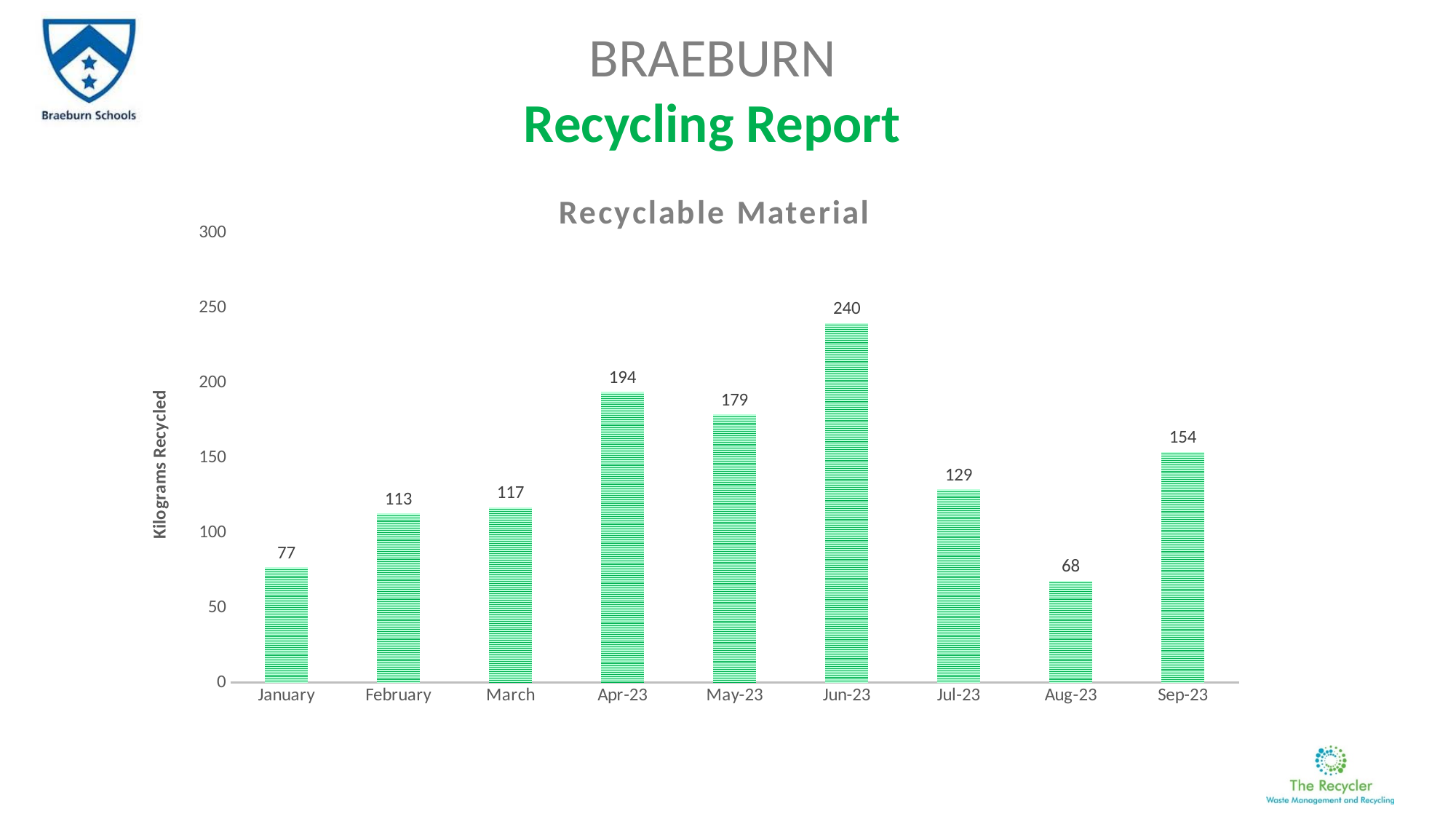
What is the value shown for Sep-23? 154 What is the difference between the values for Jun-23 and Jul-23? 111 Which month has the lowest value in the chart? Aug-23 Which is larger, the value for February or the value for March? March What kind of chart is shown on the slide? Bar chart How many kilograms were recycled in January? 77 How many months are shown on the x axis of the chart? 9 Which month has the highest value in the chart? Jun-23 Is the value for Jul-23 greater or less than 100? greater What is the value for Jun-23 in the Recyclable Material chart? 240 What is the difference between the values for Apr-23 and May-23? 15 What is the label on the vertical axis of the chart? Kilograms Recycled